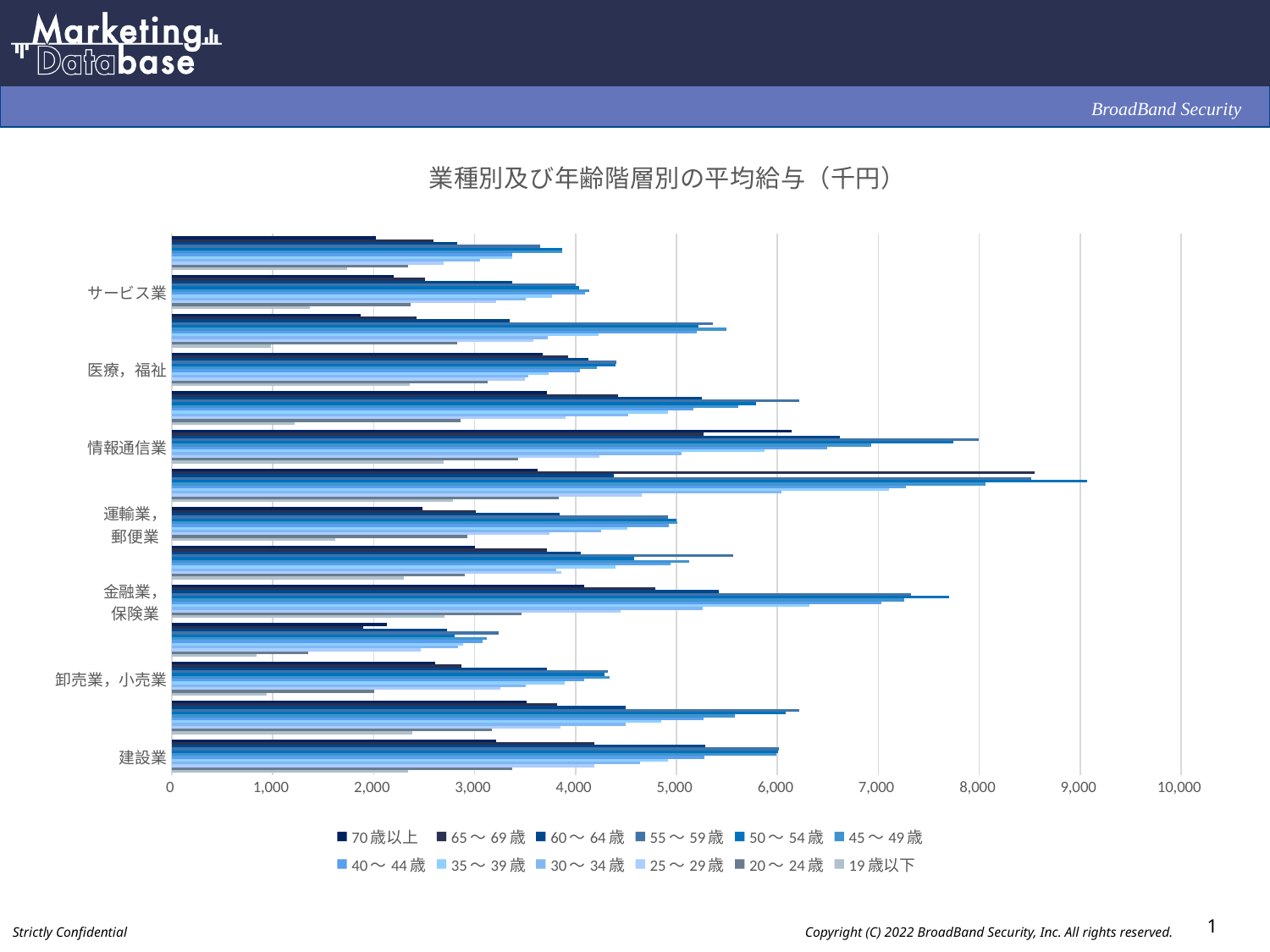
Which has a longer longest bar, 卸売業，小売業 or 運輸業，郵便業? 運輸業，郵便業 What is the first entry in the chart's legend? 70歳以上 Is the longest bar for 建設業 greater or less than 5,000? greater Which has a longer longest bar, 金融業，保険業 or 建設業? 金融業，保険業 Which has a longer longest bar, サービス業 or 情報通信業? 情報通信業 Is the longest bar for 情報通信業 greater or less than 7,000? greater How many series does the legend list? 12 What is the title of the chart? 業種別及び年齢階層別の平均給与（千円） What kind of chart is shown on the slide? bar chart Is the longest bar for 卸売業，小売業 greater or less than 5,000? less